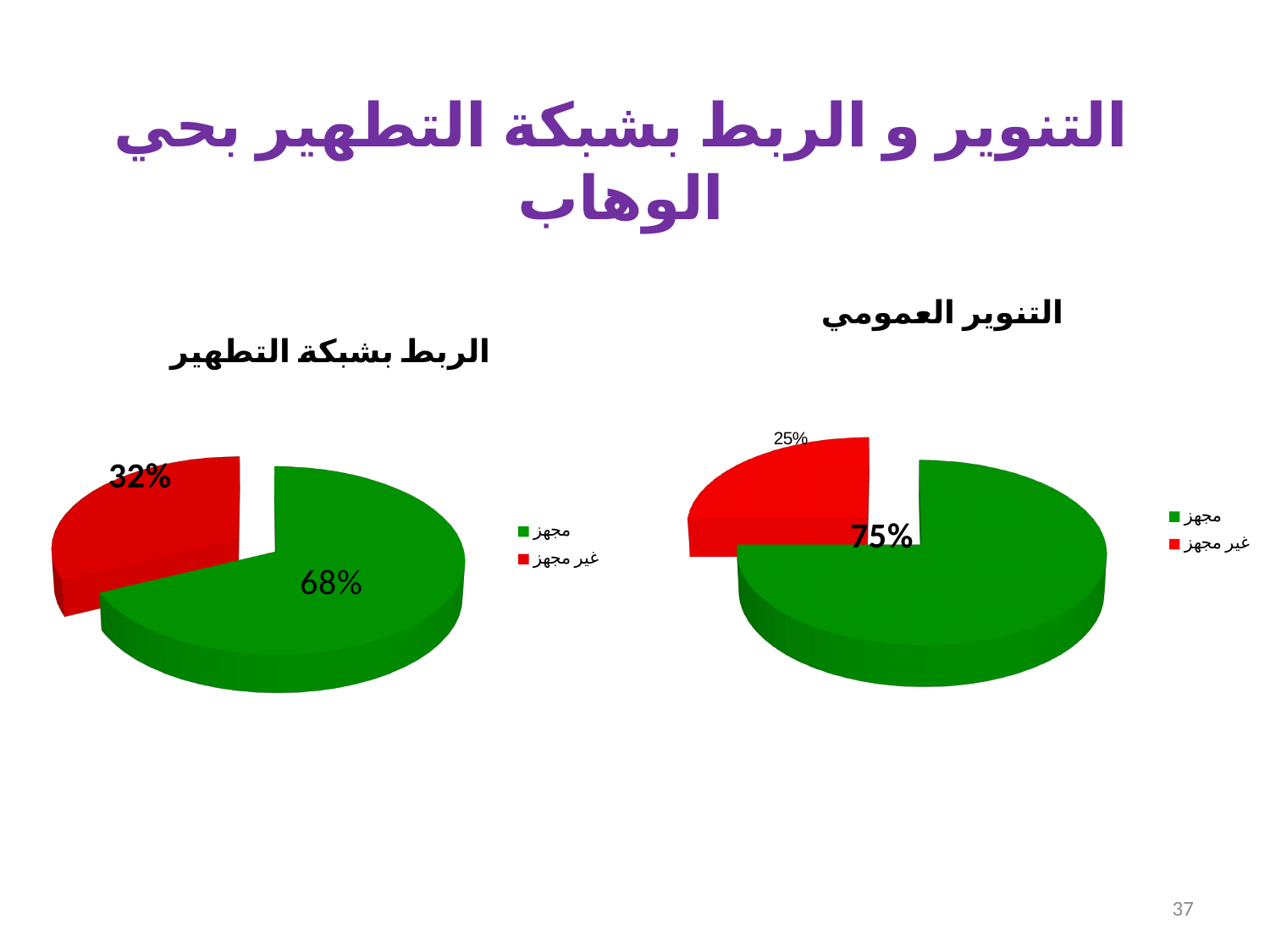
In the chart titled "الربط بشبكة التطهير", what share is labelled for the "مجهز" slice? 68% In the chart titled "الربط بشبكة التطهير", what share is labelled for the "غير مجهز" slice? 32% Which chart shows a larger "مجهز" share, "التنوير العمومي" or "الربط بشبكة التطهير"? التنوير العمومي In the chart titled "الربط بشبكة التطهير", which category has the largest slice? مجهز In the chart titled "الربط بشبكة التطهير", what is the difference between the "مجهز" and "غير مجهز" shares? 36% What type of chart is used for "التنوير العمومي"? Pie chart In the chart titled "التنوير العمومي", what is the difference between the "مجهز" and "غير مجهز" shares? 50% In the chart titled "التنوير العمومي", what share is labelled for the "غير مجهز" slice? 25% In the chart titled "التنوير العمومي", what share is labelled for the "مجهز" slice? 75% How many slices does the chart titled "الربط بشبكة التطهير" have? 2 In the chart titled "التنوير العمومي", what colour is the "غير مجهز" slice? Red In the chart titled "التنوير العمومي", which category has the smallest slice? غير مجهز